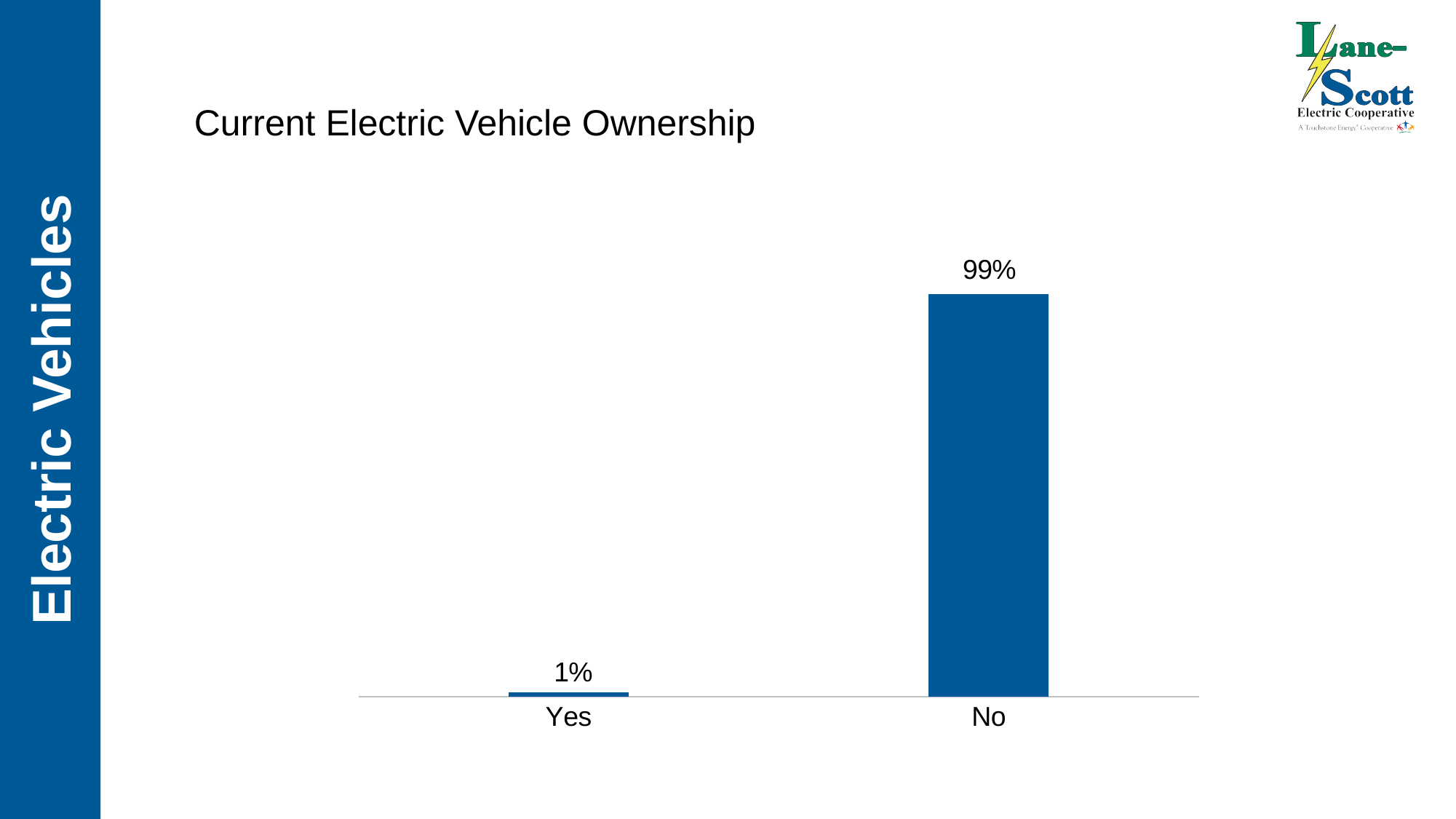
What is the difference between the values for "No" and "Yes"? 98% What is the total of the two values shown in the chart? 100% How many categories are shown in the chart? 2 What kind of chart is shown on the slide? Bar chart Which category has the lowest value in the chart? Yes Which is larger, the value for "Yes" or the value for "No"? No What is the value for "No" in the Current Electric Vehicle Ownership chart? 99% Which category has the highest value in the chart? No What is the value for "Yes" in the Current Electric Vehicle Ownership chart? 1% What is the title of the chart? Current Electric Vehicle Ownership What colour are the bars in the chart? Blue